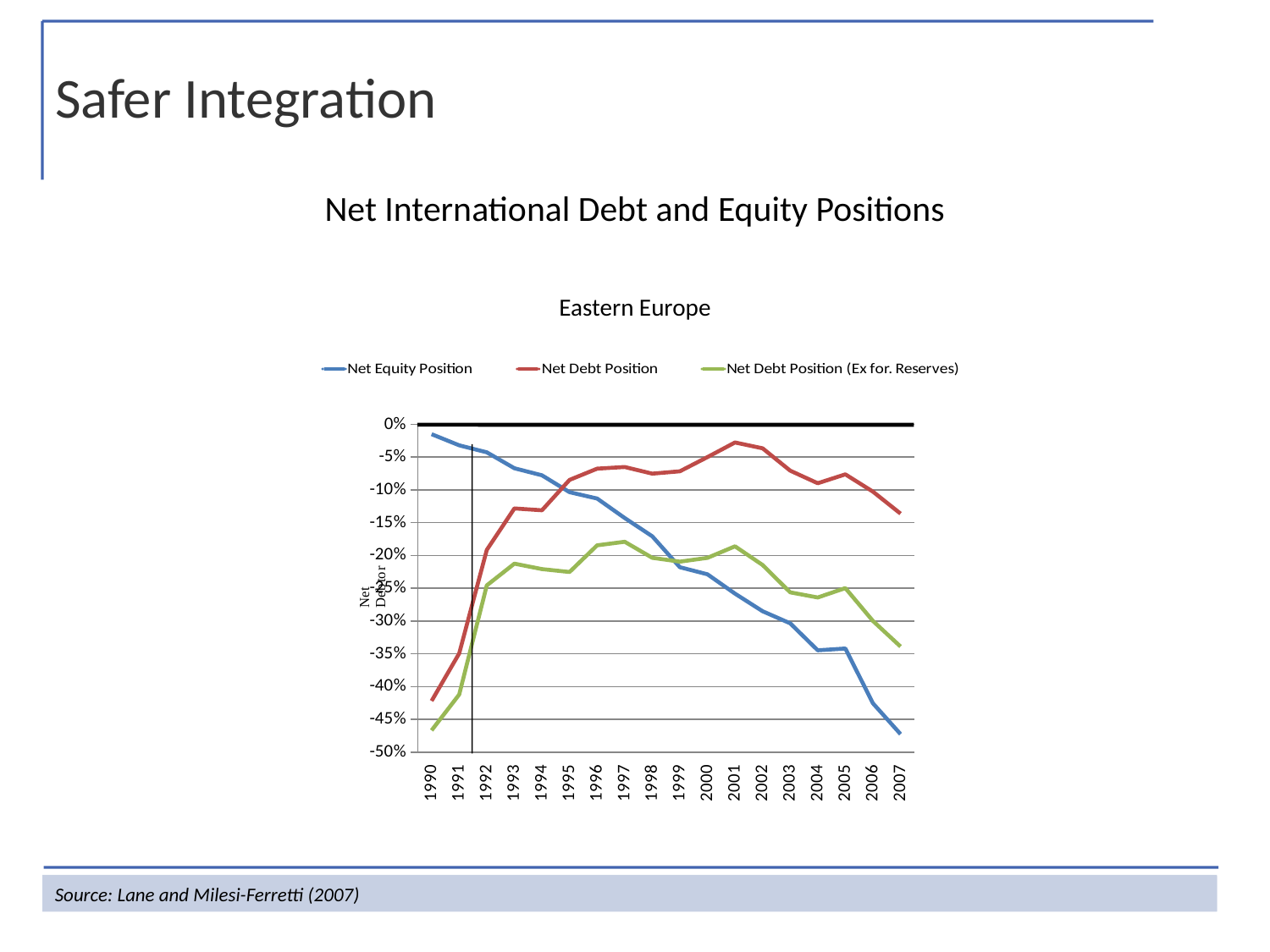
How many series does the legend of the chart list? 3 Is the Net Debt Position value for 2001 greater or less than -5%? greater Is the Net Equity Position value for 2007 greater or less than -45%? less Does the Net Debt Position line rise or fall from 1990 to 2001? rise In 2007, which is higher: the Net Debt Position or the Net Equity Position? Net Debt Position Is the Net Debt Position value for 1990 greater or less than -40%? less Does the Net Equity Position line rise or fall from 1990 to 2007? fall In which year is the Net Equity Position at its lowest? 2007 How many years are plotted along the x axis of the chart? 18 What colour is the Net Debt Position line in the chart? red What kind of chart is shown on the slide? line chart